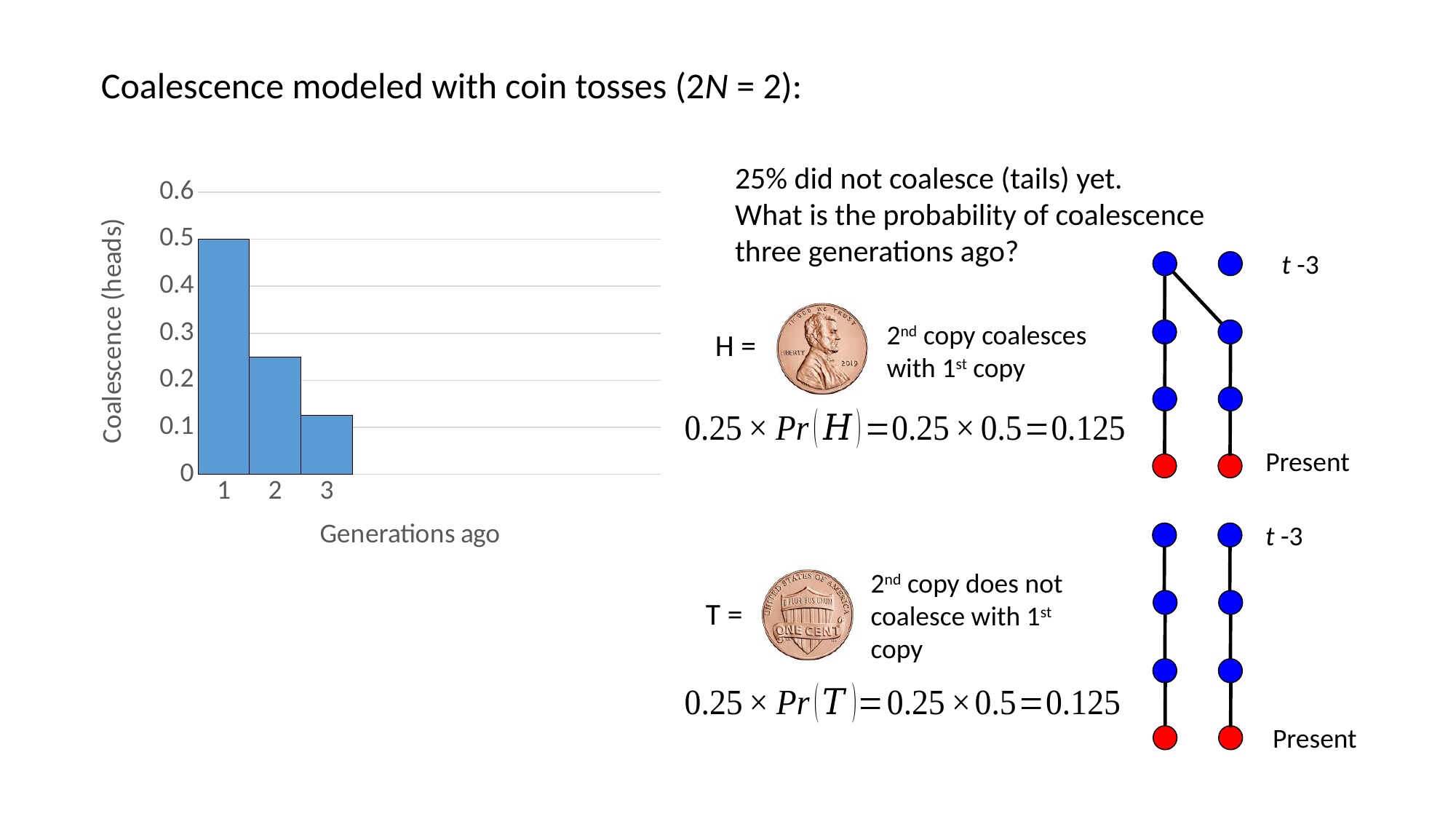
How many bars (generations) are plotted in the chart? 3 Which generation ago has the highest coalescence value in the chart? 1 What is the label of the x axis of the chart? Generations ago Is the coalescence value for 2 generations ago greater or less than 0.3? less Which has a larger coalescence value: 1 generation ago or 2 generations ago? 1 generation ago Do the coalescence values rise or fall as generations ago increases from 1 to 3? fall What is the coalescence (heads) value for 1 generation ago? 0.5 Is the coalescence value for 2 generations ago greater or less than 0.2? greater Which generation ago has the lowest coalescence value in the chart? 3 Is the coalescence value for 3 generations ago greater or less than 0.1? greater What is the label of the y axis of the chart? Coalescence (heads) What kind of chart is shown on the slide? bar chart